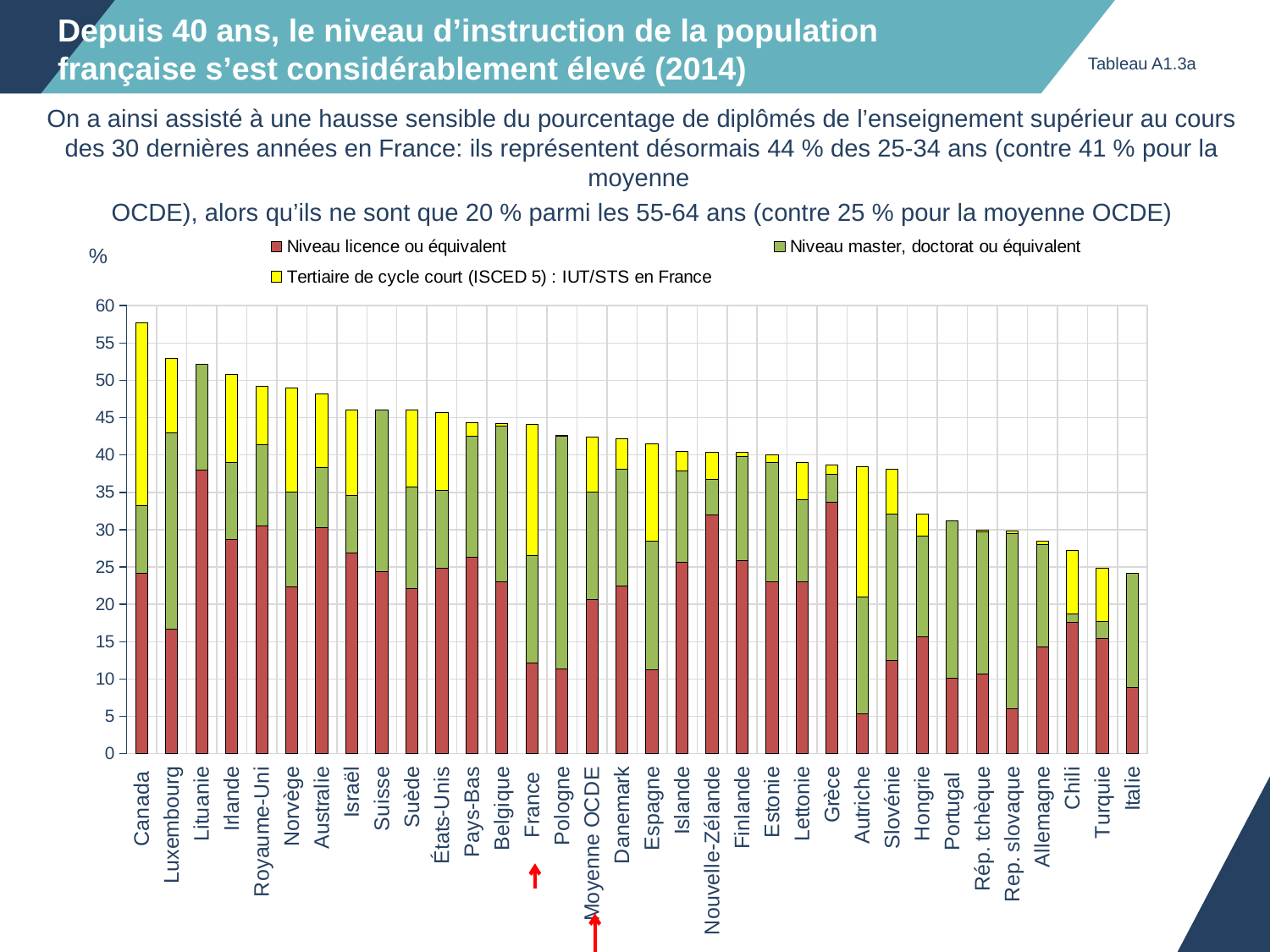
Is the 'Niveau licence ou équivalent' value for Autriche greater or less than 10? less Is the total value for Italie greater or less than 30? less Which category has the highest total bar? Canada Is the total value for Canada greater or less than 55? greater What kind of chart is shown on the slide? stacked bar chart Which legend entry is shown in yellow? Tertiaire de cycle court (ISCED 5) : IUT/STS en France Which category has the lowest total bar? Italie Which has the larger total bar, France or Turquie? France Which has the larger 'Niveau licence ou équivalent' segment, Lituanie or Luxembourg? Lituanie How many series does the legend list? 3 Do the total bar heights generally rise or fall from left to right along the x axis? fall How many countries or categories are shown on the x axis? 34